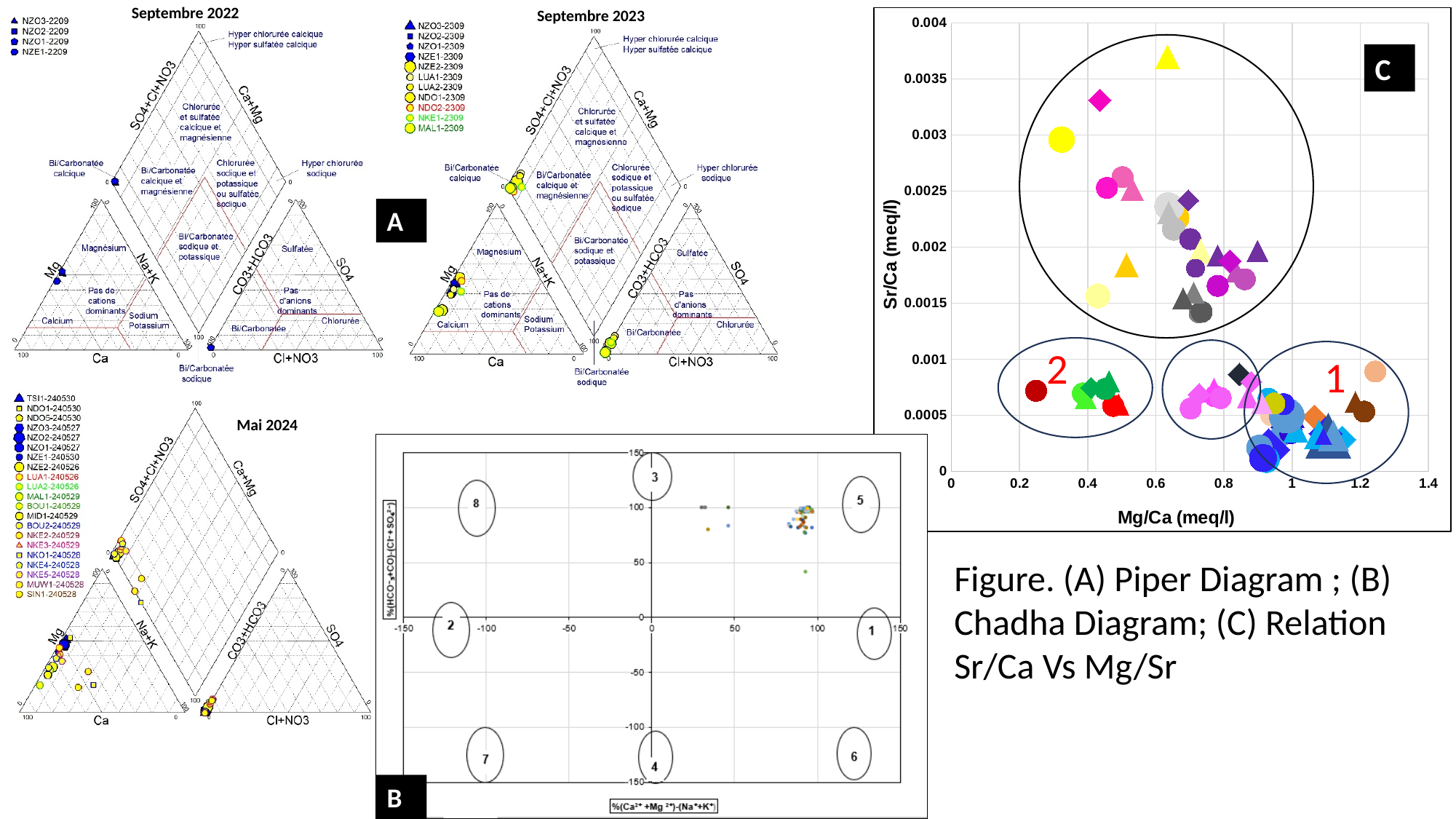
In panel A, how many sample entries does the legend of the Septembre 2022 Piper diagram list? 4 In panel B (Chadha diagram), is the vertical-axis value of the main cluster of points near x = 90 greater or less than 50? greater In panel C, are the Mg/Ca values of the points inside the circle labelled 2 greater or less than 0.6? less In panel B (Chadha diagram), how many numbered fields are marked on the plot? 8 In panel A, how many sample entries does the legend of the Septembre 2023 Piper diagram list? 11 In panel C, are the Mg/Ca values of the points inside the circle labelled 1 greater or less than 0.8? greater What kind of chart is panel C (Relation Sr/Ca vs Mg/Ca)? scatter plot In panel C, which has the higher Sr/Ca value: the yellow triangle at the top of the large circle or the points in the circle labelled 1? the yellow triangle What is the x-axis label of panel C? Mg/Ca (meq/l) How many Piper diagrams are shown in panel A? 3